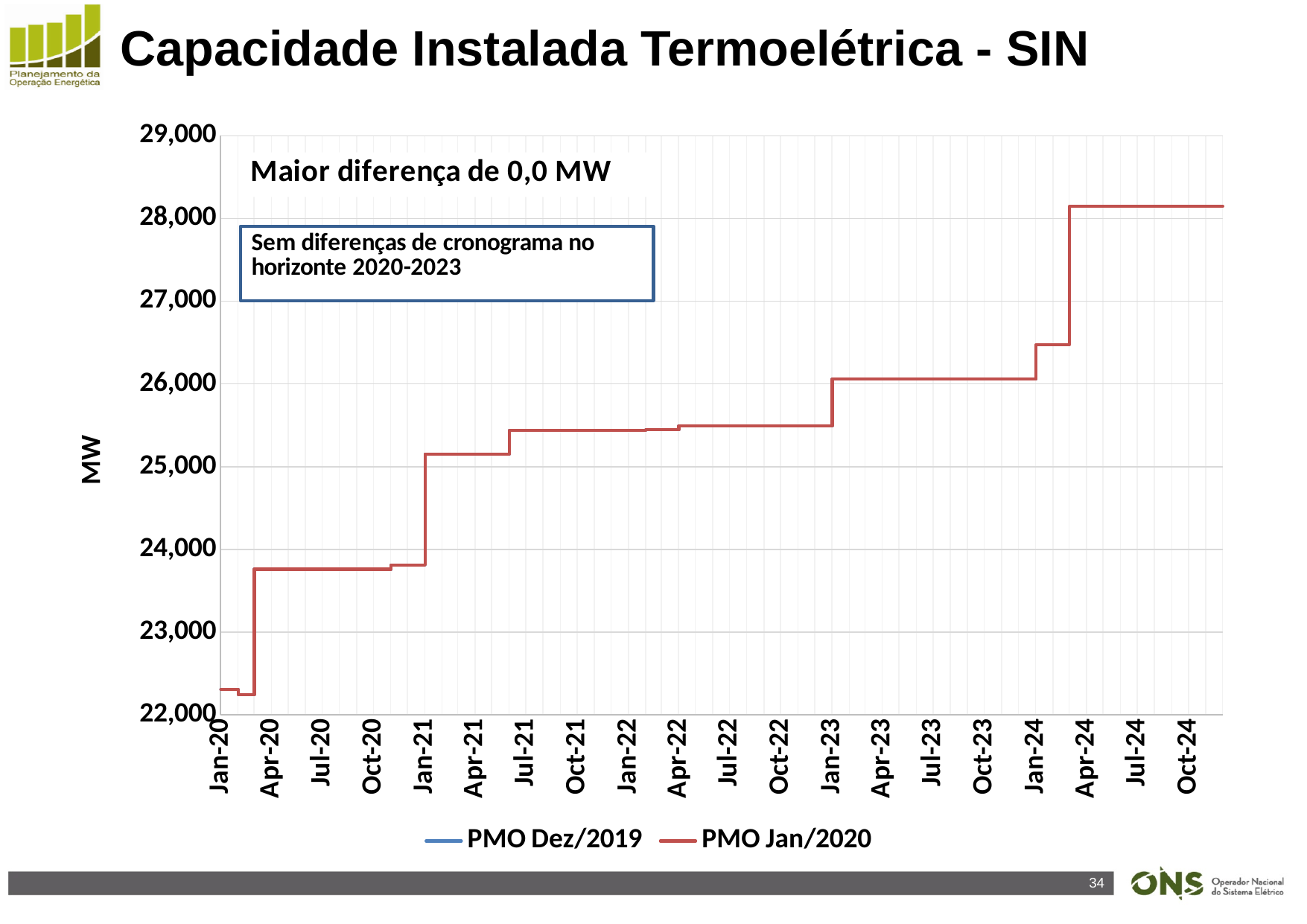
What kind of chart is shown on the slide? Line chart Is the value for Oct-24 greater or less than 28,000? greater Which is larger, the value at Oct-24 or the value at Jan-20? Oct-24 Do the values rise or fall from Jan-20 to Oct-24? Rise What is the label on the vertical axis? MW Is the value for Jul-20 greater or less than 24,000? less Is the value for Jan-24 greater or less than 27,000? less What are the two series named in the legend? PMO Dez/2019 and PMO Jan/2020 How many date labels are shown on the x axis? 20 How many series does the legend list? 2